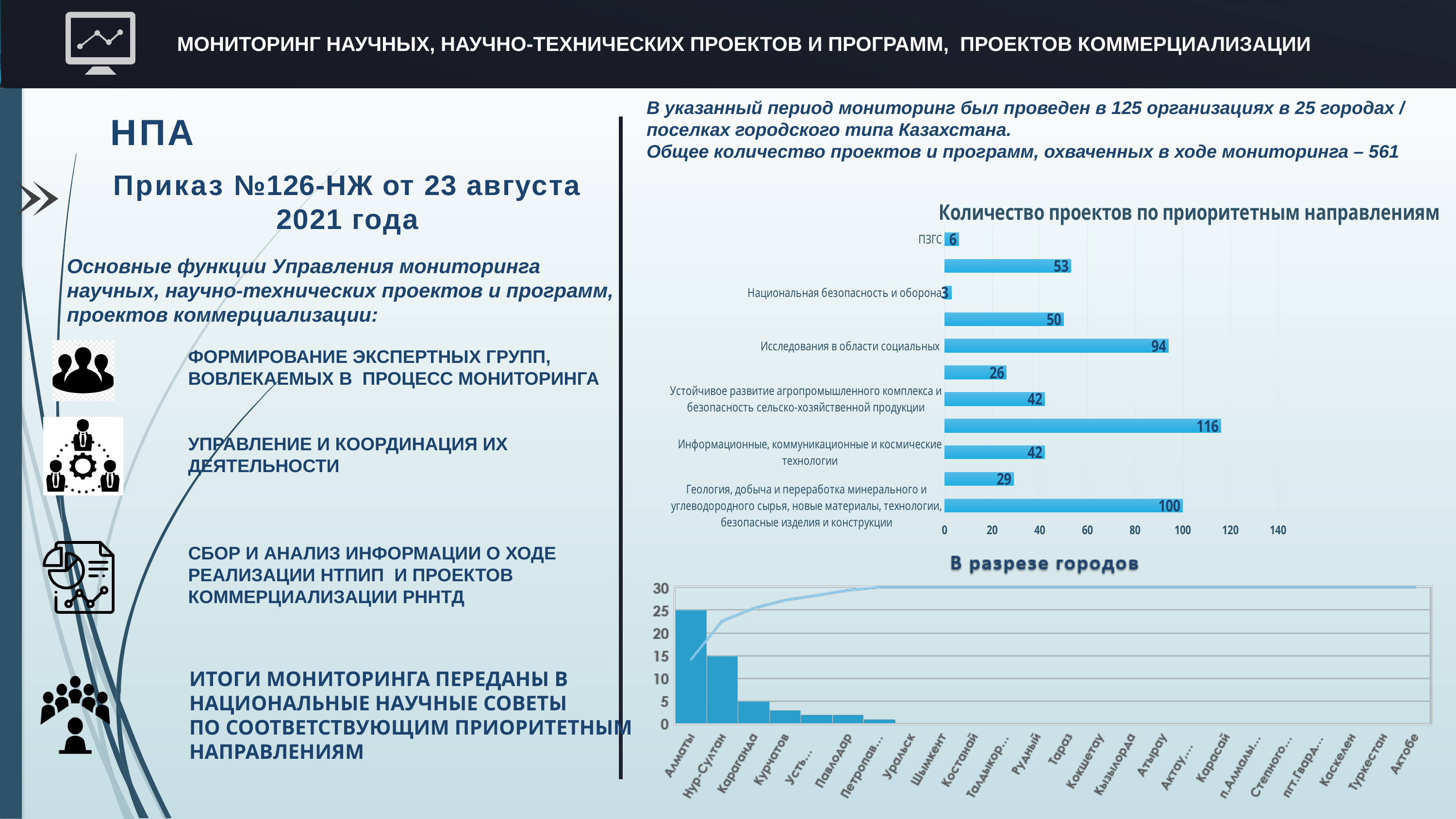
In the chart 'Количество проектов по приоритетным направлениям', what is the value for ПЗГС? 6 In the chart 'Количество проектов по приоритетным направлениям', what is the value for Национальная безопасность и оборона? 3 In the chart 'В разрезе городов', which city has the highest bar? Алматы In the chart 'Количество проектов по приоритетным направлениям', which labelled category has the lowest value? Национальная безопасность и оборона In the chart 'Количество проектов по приоритетным направлениям', what is the value for Исследования в области социальных? 94 How many bars are plotted in the chart 'Количество проектов по приоритетным направлениям'? 11 In the chart 'Количество проектов по приоритетным направлениям', which is larger: the value for Исследования в области социальных or the value for Устойчивое развитие агропромышленного комплекса? Исследования в области социальных In the chart 'В разрезе городов', is the value for Нур-Султан greater or less than 10? greater In the chart 'Количество проектов по приоритетным направлениям', what is the difference between the value for Геология (100) and the value for Исследования в области социальных (94)? 6 In the chart 'Количество проектов по приоритетным направлениям', what is the value for Геология, добыча и переработка минерального и углеводородного сырья, новые материалы, технологии, безопасные изделия и конструкции? 100 In the chart 'Количество проектов по приоритетным направлениям', what is the value for Информационные, коммуникационные и космические технологии? 42 What kind of chart is 'Количество проектов по приоритетным направлениям'? bar chart